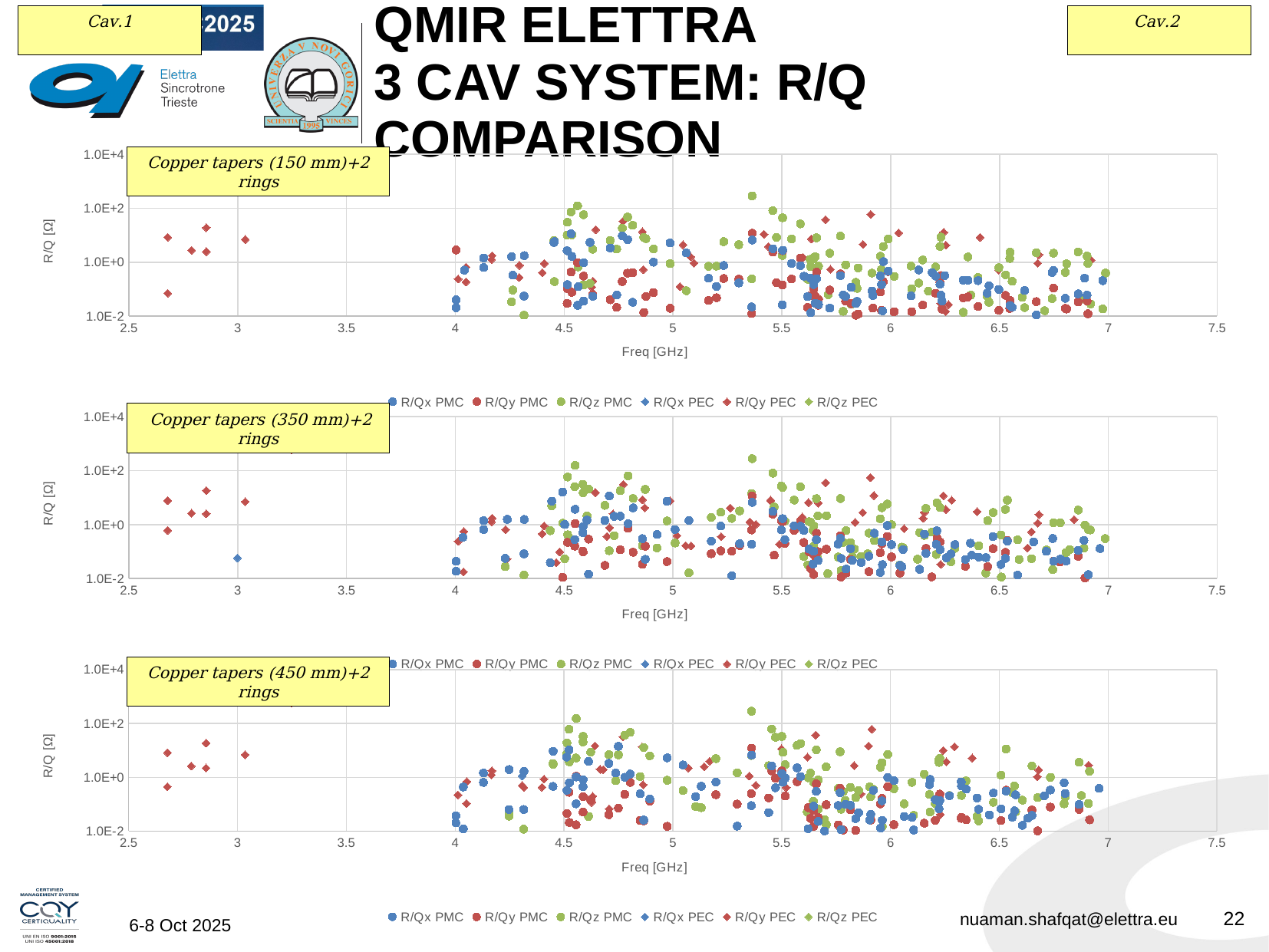
In the middle chart, 'Copper tapers (350 mm)+2 rings', is the lowest R/Qx PEC point near 3 GHz greater or less than 1.0E+0? less What is the y-axis title of the top chart, 'Copper tapers (150 mm)+2 rings'? R/Q [Ω] In the top chart, 'Copper tapers (150 mm)+2 rings', is the highest R/Qz PMC point greater or less than 1.0E+2? greater What is the lowest tick value shown on the y axis of the bottom chart, 'Copper tapers (450 mm)+2 rings'? 1.0E-2 How many charts are shown on the slide? 3 In the top chart, 'Copper tapers (150 mm)+2 rings', which series is plotted with green circles according to the legend? R/Qz PMC What kind of chart is the top chart titled 'Copper tapers (150 mm)+2 rings'? Scatter chart In the bottom chart, 'Copper tapers (450 mm)+2 rings', is the highest R/Qz PMC point greater or less than 1.0E+2? greater What is the x-axis title of the bottom chart, 'Copper tapers (450 mm)+2 rings'? Freq [GHz] What is the maximum value shown on the x axis of the middle chart, 'Copper tapers (350 mm)+2 rings'? 7.5 How many series does the legend list for the middle chart, 'Copper tapers (350 mm)+2 rings'? 6